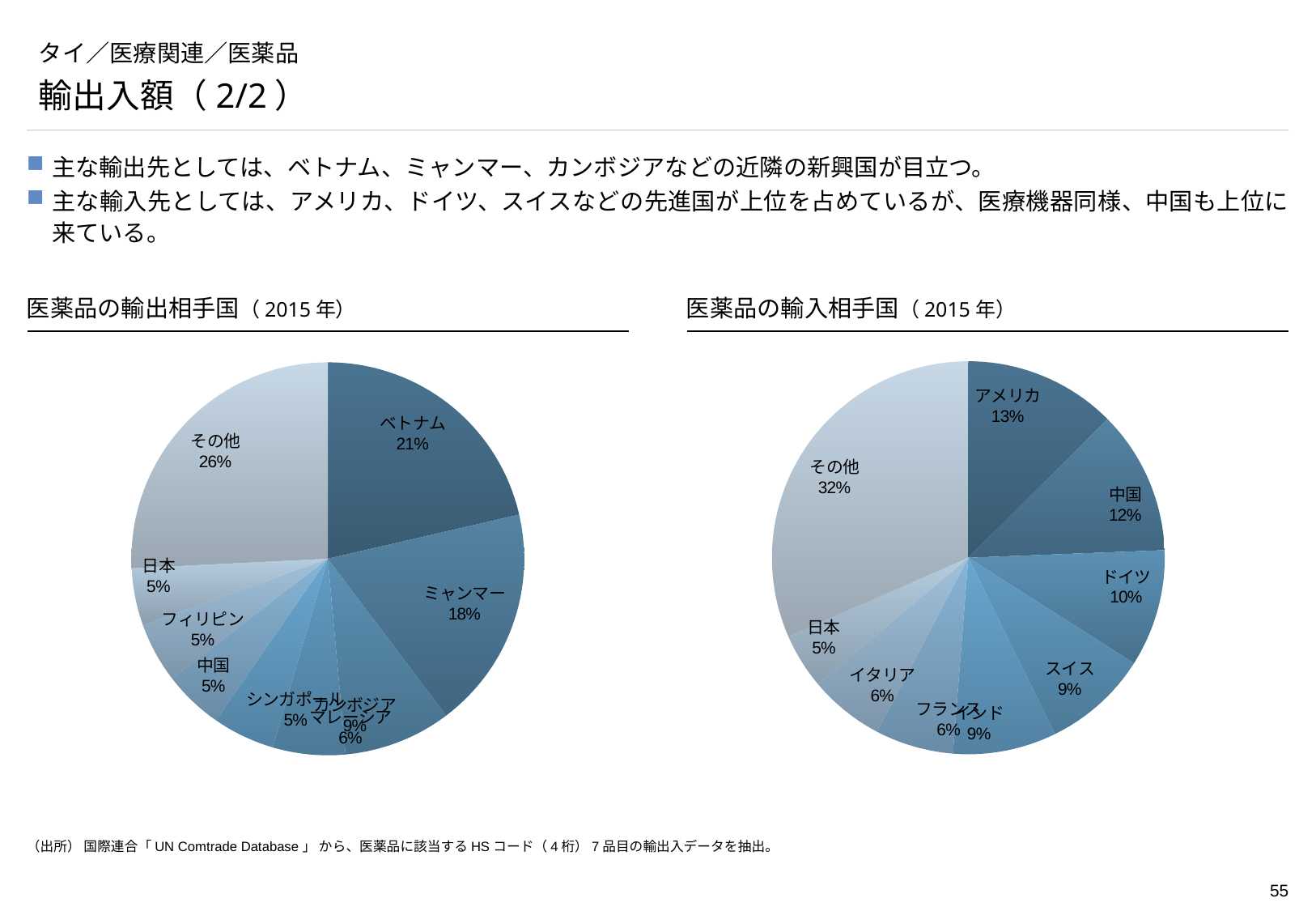
In the 医薬品の輸入相手国（2015年） chart, what share does アメリカ have? 13% In the 医薬品の輸出相手国（2015年） chart, what is the difference between the shares of ベトナム and ミャンマー? 3% In the 医薬品の輸入相手国（2015年） chart, what share does ドイツ have? 10% In the 医薬品の輸入相手国（2015年） chart, which is larger, the share of スイス or the share of 日本? スイス In the 医薬品の輸入相手国（2015年） chart, what share does 中国 have? 12% How many slices does the 医薬品の輸入相手国（2015年） chart have? 9 In the 医薬品の輸出相手国（2015年） chart, what share does その他 have? 26% In the 医薬品の輸出相手国（2015年） chart, what share does ミャンマー have? 18% In the 医薬品の輸入相手国（2015年） chart, what share does その他 have? 32% In the 医薬品の輸出相手国（2015年） chart, which named country (excluding その他) has the largest share? ベトナム In the 医薬品の輸出相手国（2015年） chart, what share does ベトナム have? 21% What type of chart is the 医薬品の輸出相手国（2015年） chart? Pie chart